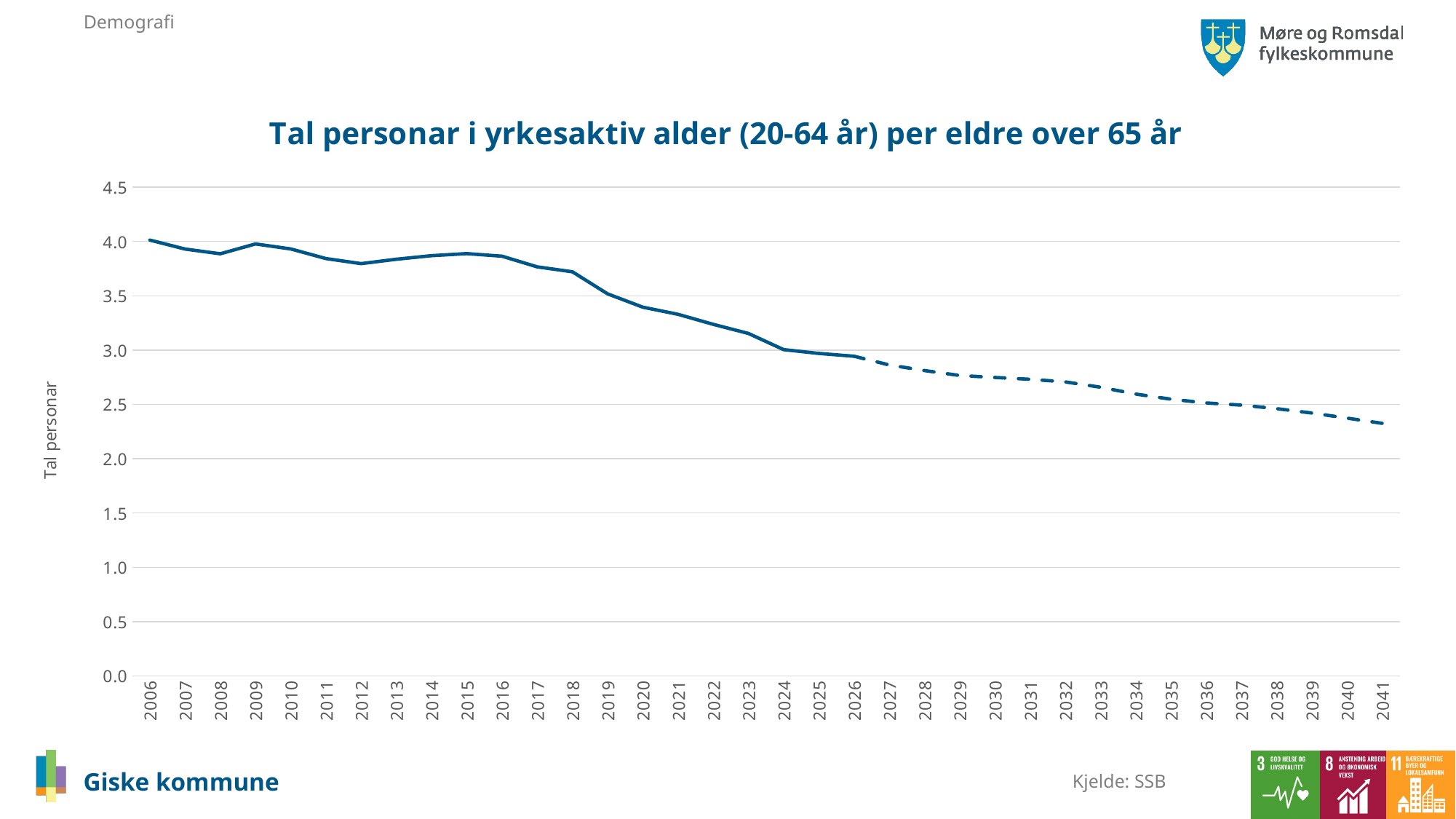
Do the values generally rise or fall from 2006 to 2041? fall Is the value for 2018 greater or less than 3.5? greater What is the label on the vertical axis of the chart? Tal personar Which year has the lowest value on the chart? 2041 Is the value for 2020 greater or less than 3.5? less Is the value for 2041 greater or less than 2.5? less What kind of chart is shown on the slide? line chart Which year has the larger value, 2015 or 2025? 2015 How many years are shown along the x axis of the chart? 36 What is the title of the chart? Tal personar i yrkesaktiv alder (20-64 år) per eldre over 65 år